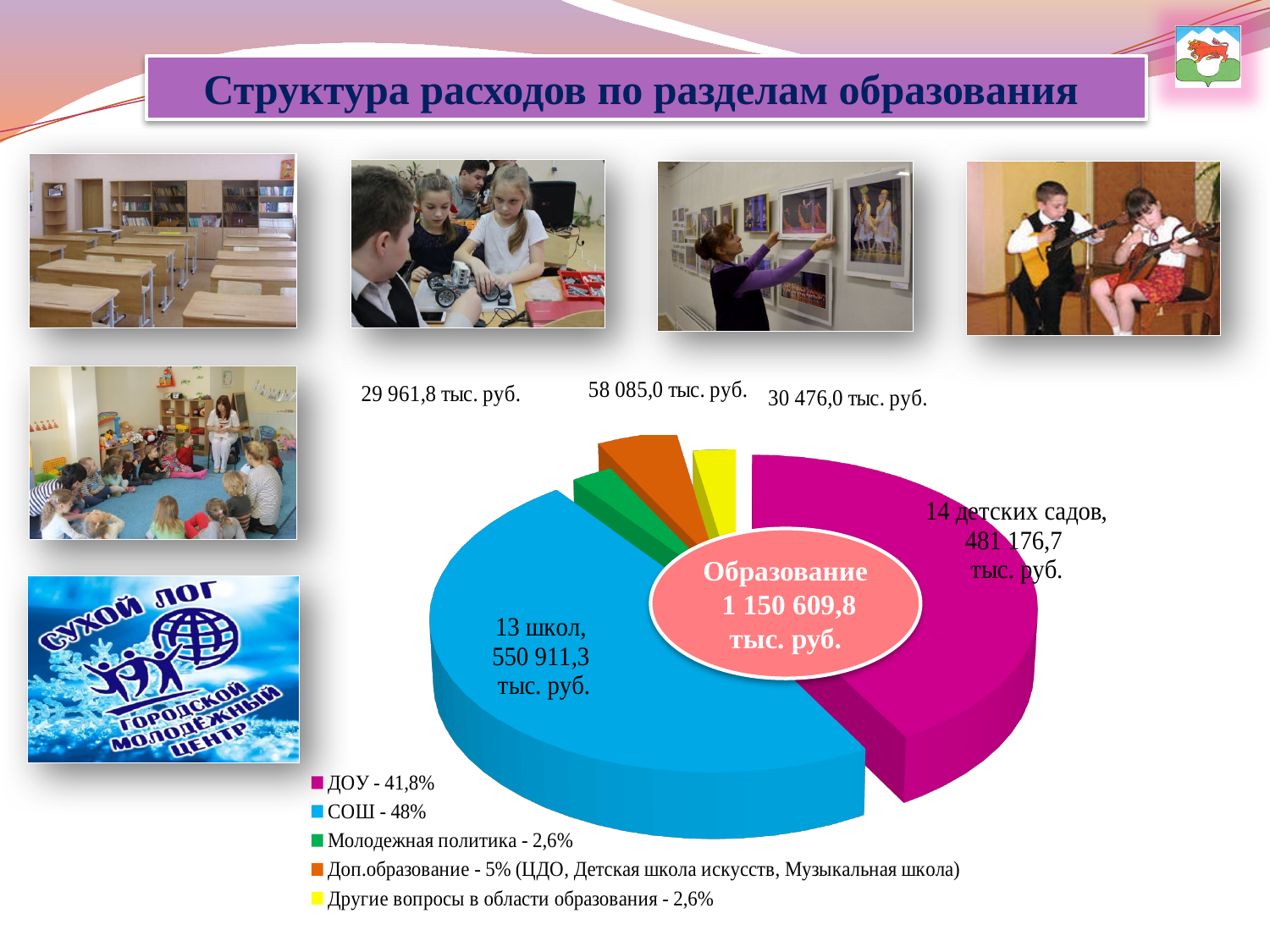
How many categories does the pie chart's legend list? 5 What kind of chart is shown on the slide? pie chart Which category has the largest share of the pie? СОШ What share of expenditure does ДОУ account for according to the legend? 41,8% What is the expenditure amount labelled for the 14 детских садов slice? 481 176,7 тыс. руб. Which has the larger share, ДОУ or СОШ? СОШ What is the title of the slide containing the pie chart? Структура расходов по разделам образования What share does Доп.образование account for according to the legend? 5% What is the total expenditure on Образование shown in the centre of the pie chart? 1 150 609,8 тыс. руб. What is the expenditure amount labelled for the 13 школ slice? 550 911,3 тыс. руб. What share of expenditure does СОШ account for according to the legend? 48% By how much does the amount for 13 школ exceed the amount for 14 детских садов? 69 734,6 тыс. руб.